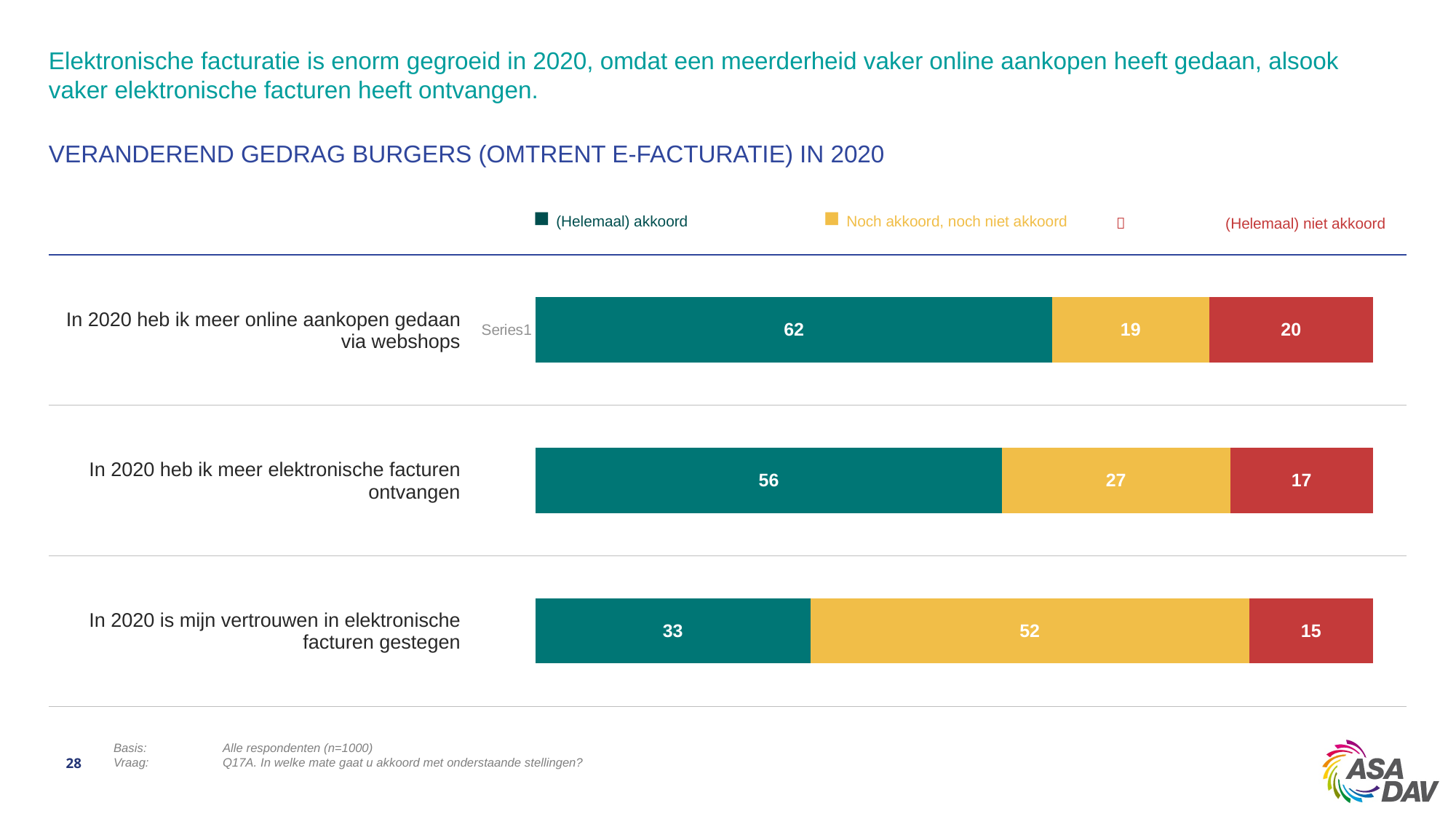
What kind of chart is shown on the slide? Stacked bar chart What colour represents "(Helemaal) niet akkoord" in the chart? Red Which statement has the highest "(Helemaal) akkoord" value? In 2020 heb ik meer online aankopen gedaan via webshops What is the value for "(Helemaal) niet akkoord" for the statement "In 2020 heb ik meer elektronische facturen ontvangen"? 17 What percentage of respondents (helemaal) akkoord with the statement "In 2020 heb ik meer online aankopen gedaan via webshops"? 62 How many series does the legend list? 3 What is the difference between the "(Helemaal) akkoord" values for "In 2020 heb ik meer online aankopen gedaan via webshops" and "In 2020 heb ik meer elektronische facturen ontvangen"? 6 What is the value for "Noch akkoord, noch niet akkoord" for the statement "In 2020 is mijn vertrouwen in elektronische facturen gestegen"? 52 What is the total of the stacked bar for "In 2020 is mijn vertrouwen in elektronische facturen gestegen"? 100 Which statement has the lowest "(Helemaal) niet akkoord" value? In 2020 is mijn vertrouwen in elektronische facturen gestegen Which is larger for the statement "In 2020 heb ik meer elektronische facturen ontvangen": the "Noch akkoord, noch niet akkoord" value or the "(Helemaal) niet akkoord" value? Noch akkoord, noch niet akkoord How many statements are shown in the chart? 3